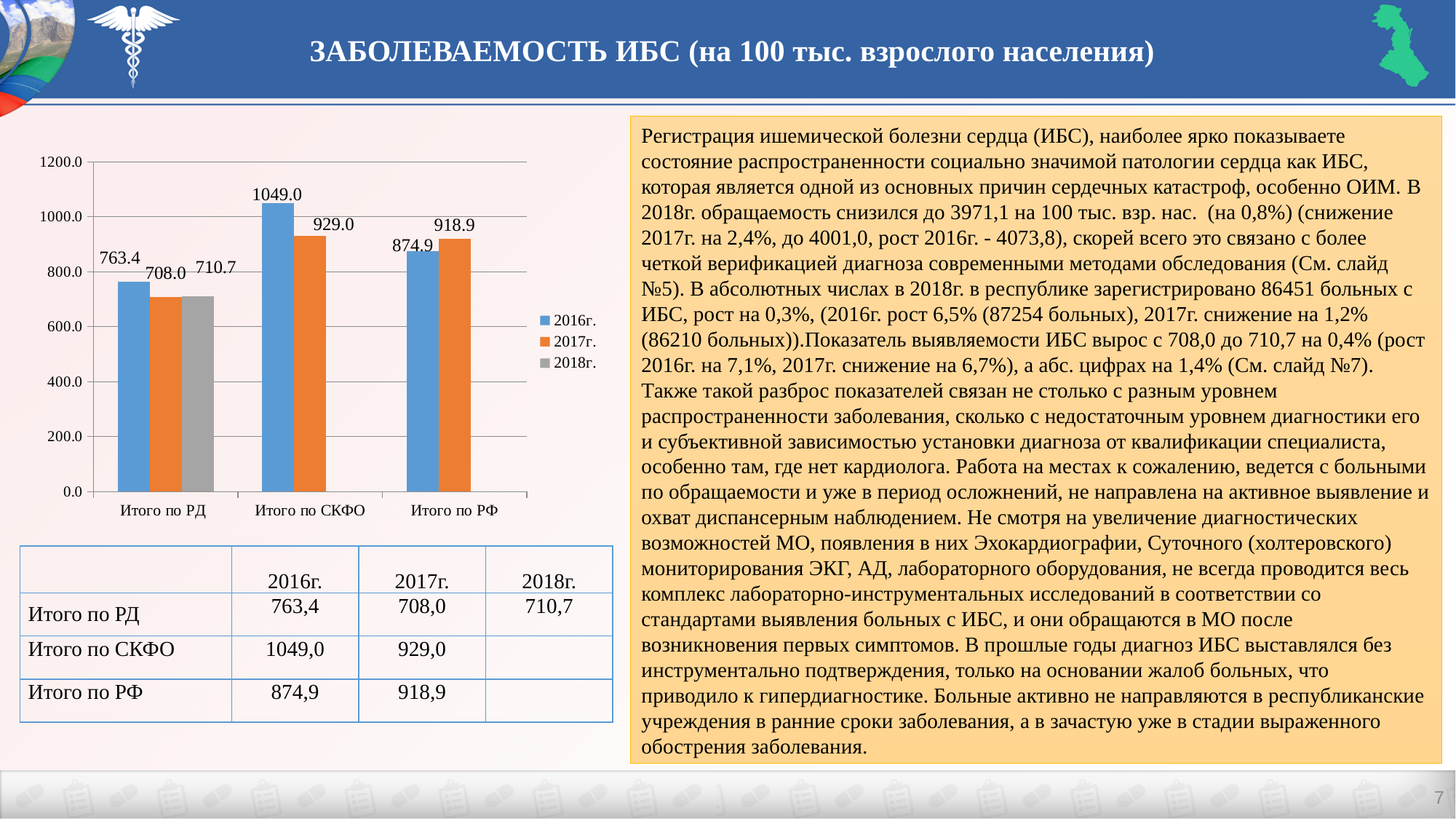
Which is larger for Итого по РФ: the 2016г. value or the 2017г. value? 2017г. Which category has the highest 2016г. value? Итого по СКФО How many series does the chart legend list? 3 What is the 2017г. value for Итого по РФ? 918.9 What is the 2016г. value for Итого по СКФО? 1049.0 What is the difference between the 2016г. and 2017г. values for Итого по СКФО? 120.0 What is the 2018г. value for Итого по РД? 710.7 How many categories are shown on the x axis of the chart? 3 Which category is the only one with a 2018г. bar in the chart? Итого по РД Which category has the lowest 2017г. value? Итого по РД Is the 2016г. value for Итого по СКФО greater or less than 1000.0? greater What kind of chart is shown on the slide? bar chart